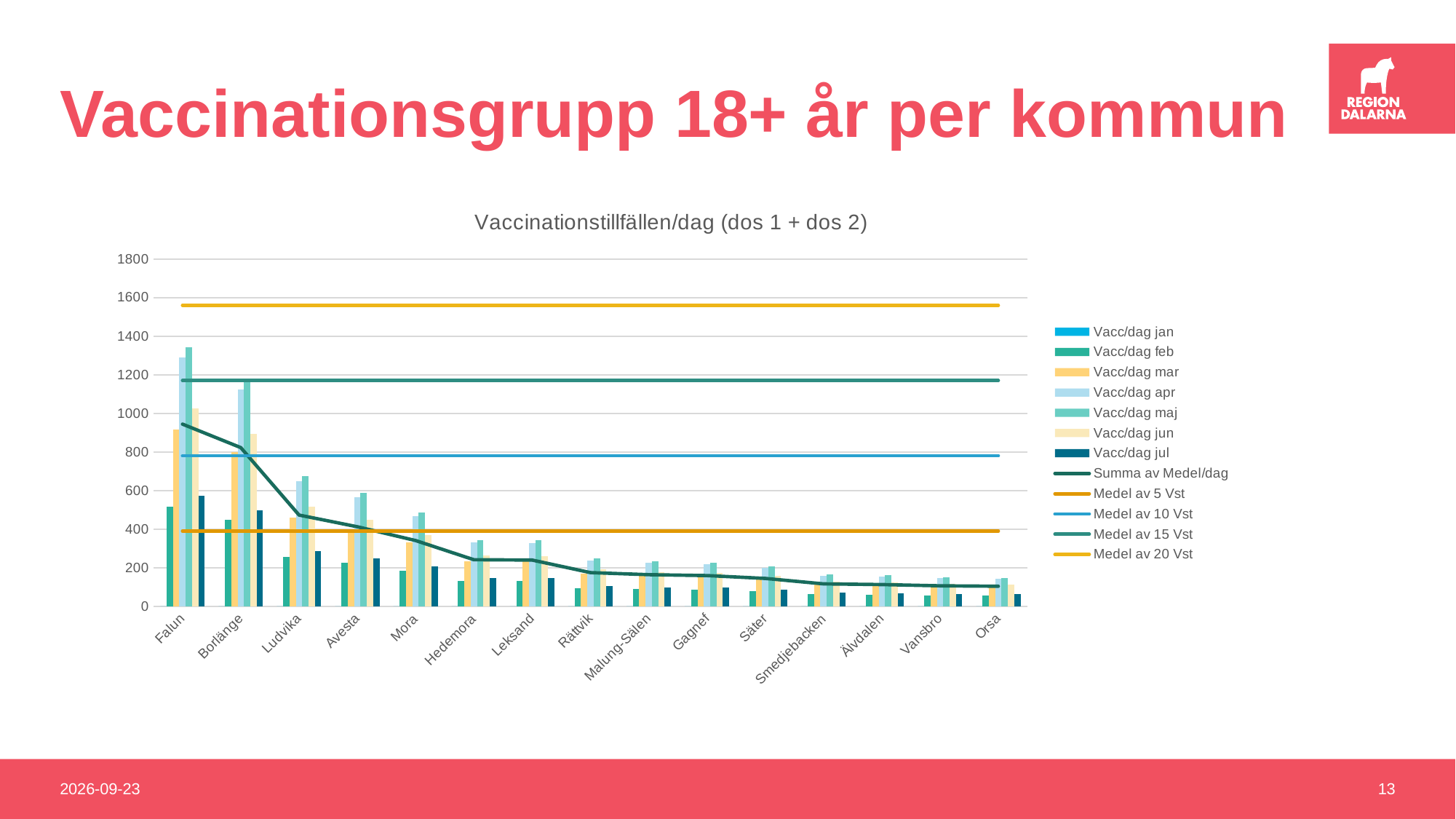
Is the Medel av 20 Vst line greater or less than 1400? greater Which is larger, the Vacc/dag jul value for Falun or for Borlänge? Falun Which municipality has the highest Vacc/dag maj bar? Falun Is the Medel av 5 Vst line greater or less than 600? less Is the Medel av 15 Vst line greater or less than 1000? greater What is the title of the chart? Vaccinationstillfällen/dag (dos 1 + dos 2) How many municipalities are shown on the x axis of the chart? 15 How many series does the chart legend list? 12 What kind of chart is shown on the slide? A bar chart combined with line series Does the Summa av Medel/dag line rise or fall from Falun to Orsa? It falls